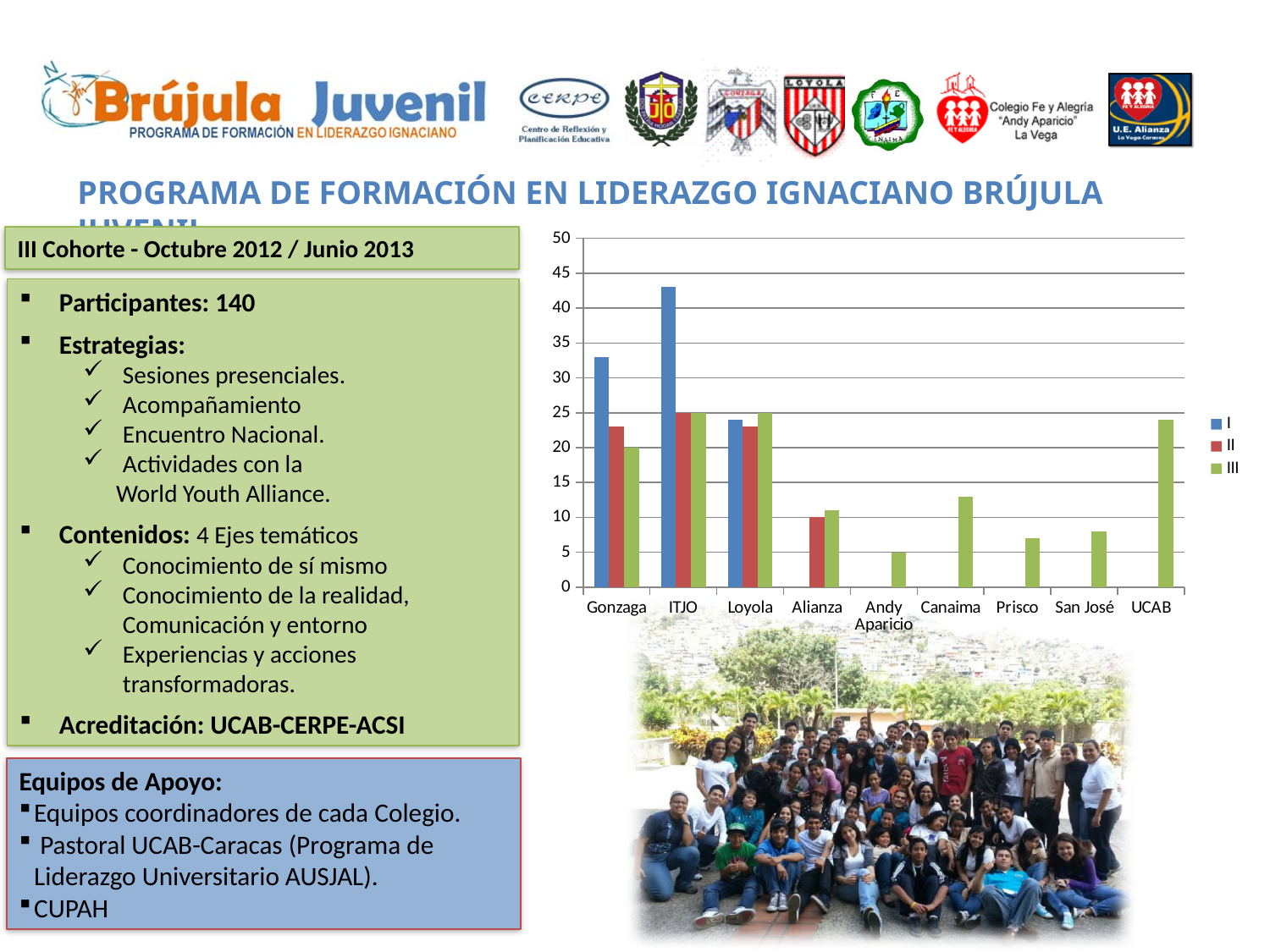
Which is larger: series I at Gonzaga or series I at Loyola? series I at Gonzaga What are the entries listed in the chart legend? I, II, III How many series does the chart legend list? 3 Which category has the highest value for series I? ITJO What is the value for series III at Andy Aparicio? 5 Which is larger: series III at UCAB or series III at San José? series III at UCAB Which category has the lowest value for series III? Andy Aparicio How many categories are shown along the x axis of the chart? 9 Is the value for series III at Canaima greater or less than 15? less What kind of chart is shown on the slide? bar chart What is the value for series II at Alianza? 10 Is the value for series I at ITJO greater or less than 40? greater